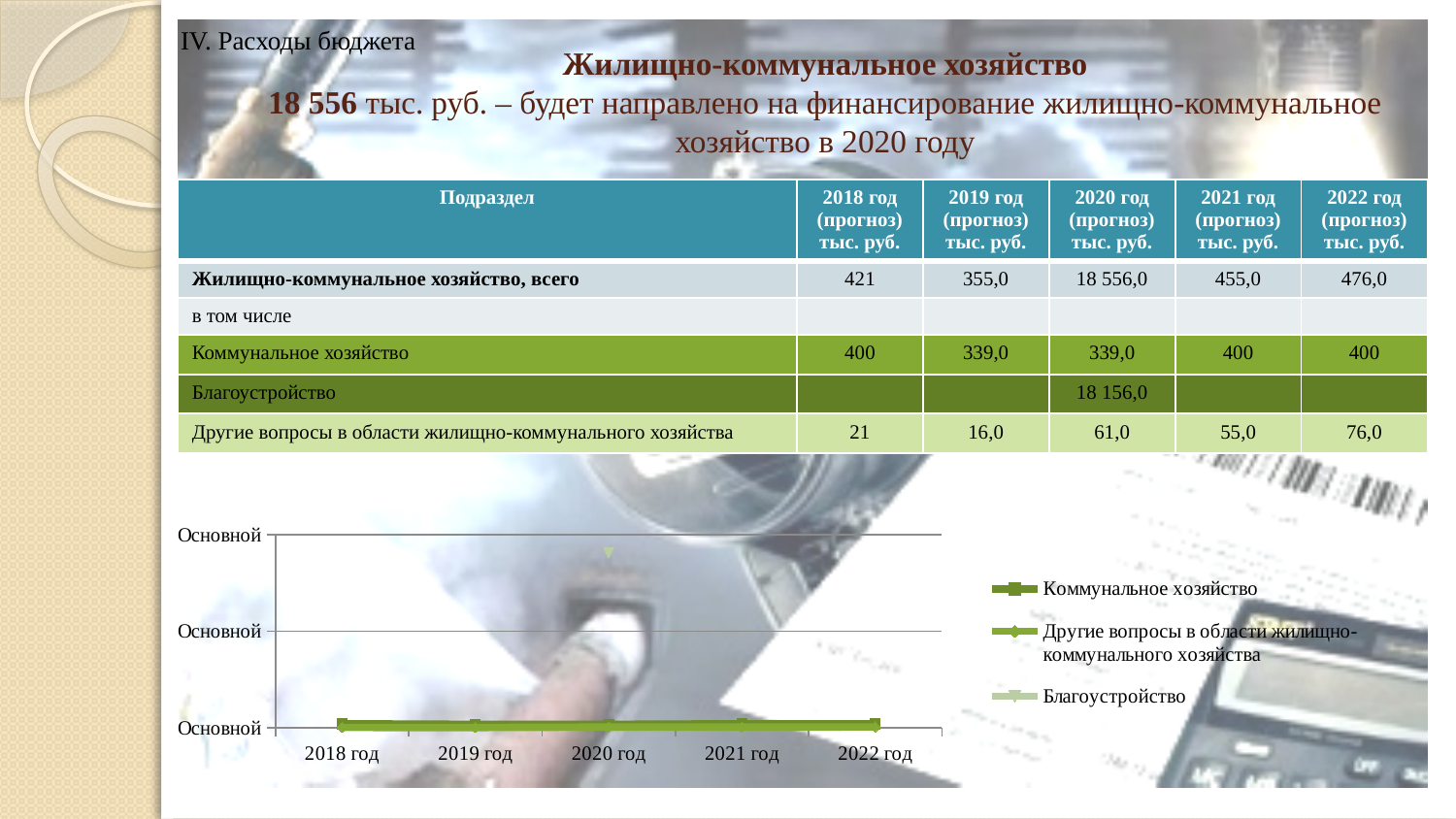
What text is used for the tick labels on the chart's y axis? Основной In which year does the Благоустройство series reach its highest point on the chart? 2020 год In 2020 год, which series is plotted higher on the chart: Благоустройство or Коммунальное хозяйство? Благоустройство What is the first category on the chart's x axis? 2018 год What is the first entry in the chart legend? Коммунальное хозяйство What is the last category on the chart's x axis? 2022 год How many series does the chart legend list? 3 What kind of chart is shown at the bottom of the slide? line chart How many year categories are shown on the x axis of the chart? 5